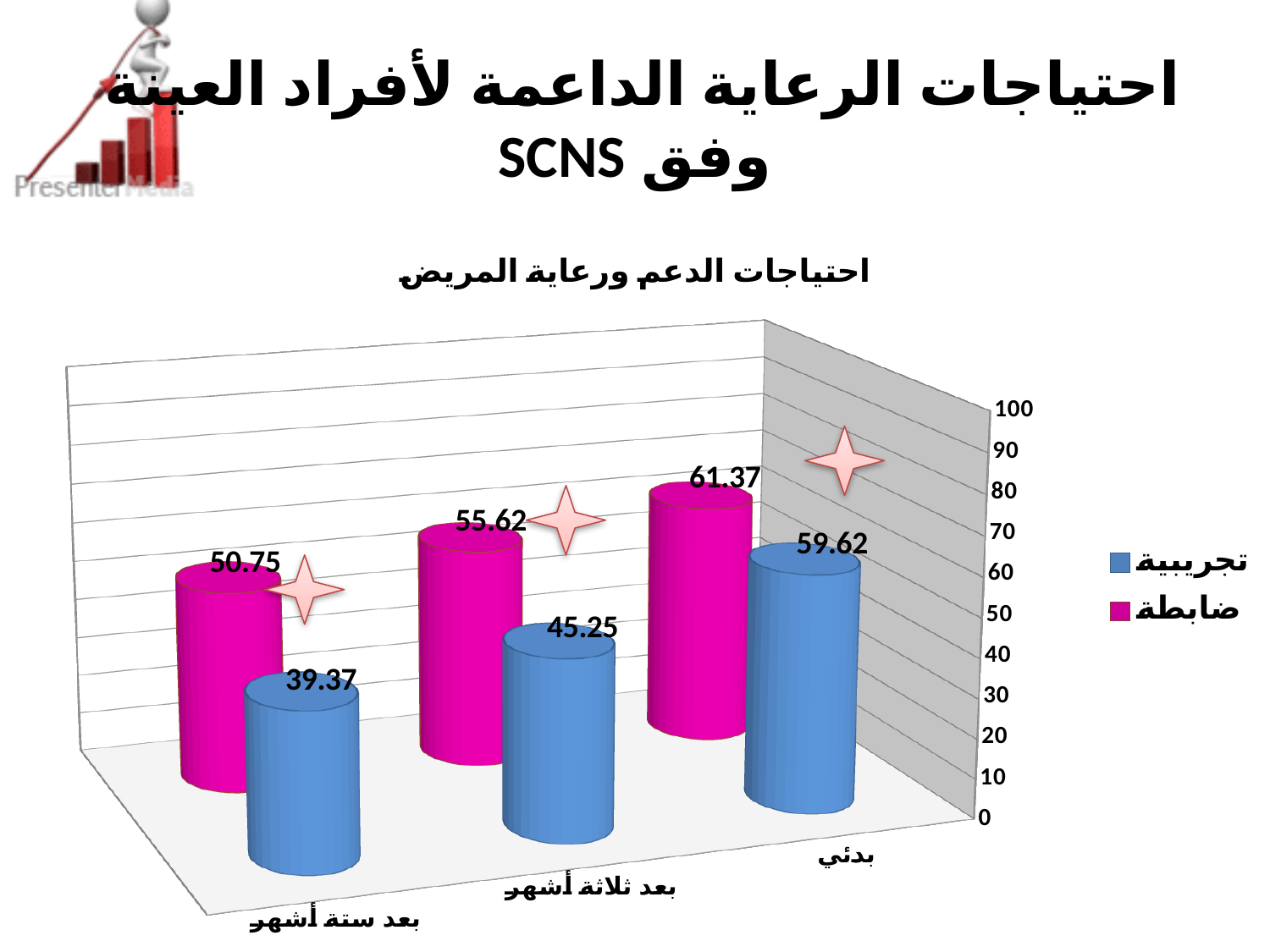
What is the value for تجريبية at بعد ثلاثة أشهر? 45.25 What kind of chart is shown on the slide? bar chart Which is larger at بعد ثلاثة أشهر, ضابطة or تجريبية? ضابطة What is the value for ضابطة at بعد ستة أشهر? 50.75 How many categories are shown on the x axis? 3 Which category has the lowest value for the تجريبية series? بعد ستة أشهر What is the difference between ضابطة and تجريبية at بعد ستة أشهر? 11.38 Which category has the highest value for the ضابطة series? بدئي What is the value for تجريبية at بدئي? 59.62 How many series does the legend list? 2 What is the value for ضابطة at بدئي? 61.37 What is the title of the chart? احتياجات الدعم ورعاية المريض